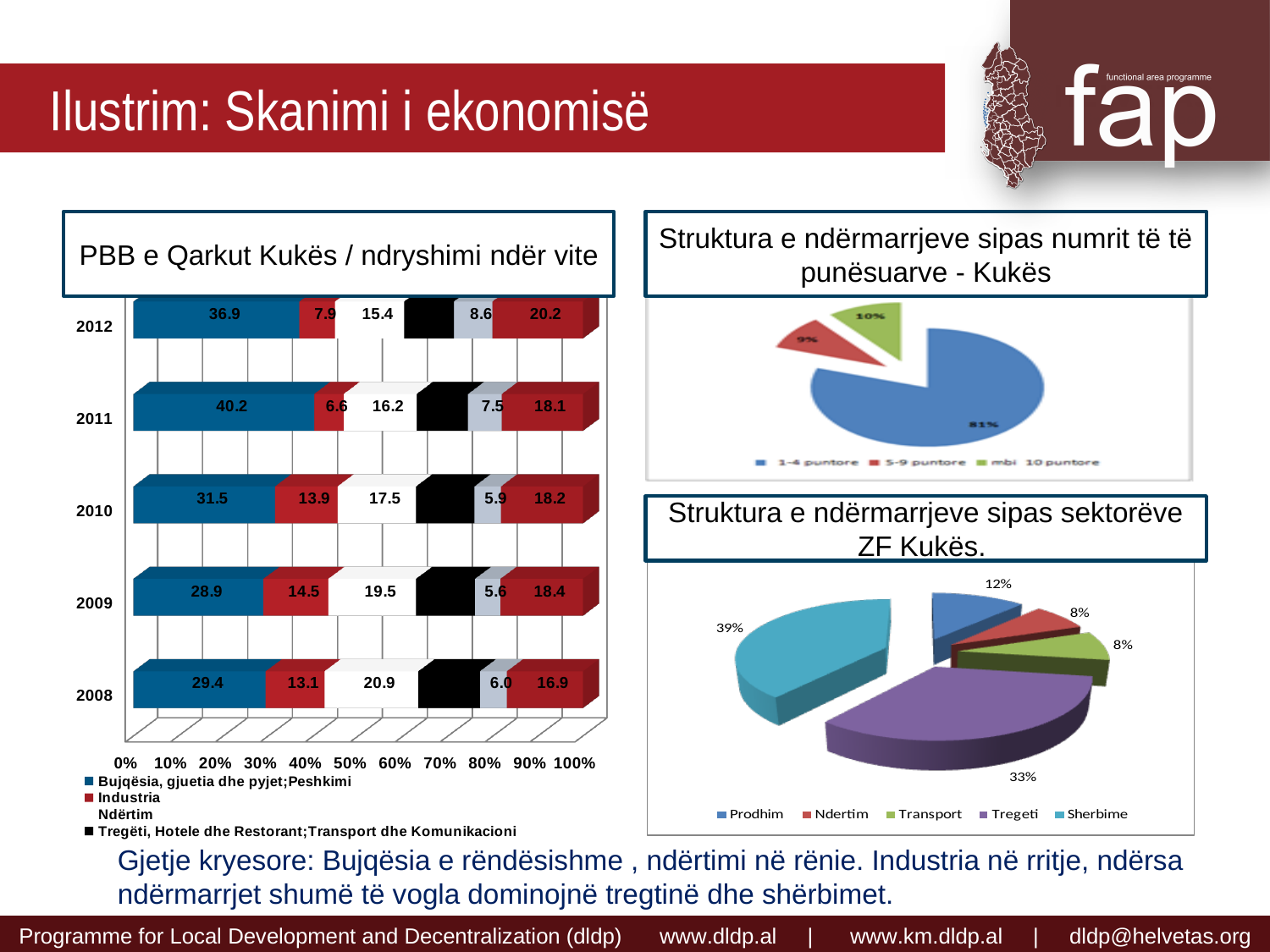
How many years are shown in the chart 'PBB e Qarkut Kukës / ndryshimi ndër vite'? 5 In the chart 'PBB e Qarkut Kukës / ndryshimi ndër vite', what is the value for Industria in 2010? 13.9 In the pie chart 'Struktura e ndërmarrjeve sipas sektorëve ZF Kukës', what is the share of Tregeti? 33% In the pie chart 'Struktura e ndërmarrjeve sipas sektorëve ZF Kukës', which sector has the largest share? Sherbime In the chart 'PBB e Qarkut Kukës / ndryshimi ndër vite', which year has the highest value for Bujqësia, gjuetia dhe pyjet;Peshkimi? 2011 In the pie chart 'Struktura e ndërmarrjeve sipas numrit të të punësuarve - Kukës', what share do enterprises with 1-4 puntore have? 81% In the chart 'PBB e Qarkut Kukës / ndryshimi ndër vite', does the Ndërtim value rise or fall from 2008 to 2012? fall In the chart 'PBB e Qarkut Kukës / ndryshimi ndër vite', is the Industria value larger in 2009 or in 2012? 2009 In the chart 'PBB e Qarkut Kukës / ndryshimi ndër vite', what is the value for Ndërtim in 2008? 20.9 What kind of chart is 'PBB e Qarkut Kukës / ndryshimi ndër vite'? bar chart In the chart 'PBB e Qarkut Kukës / ndryshimi ndër vite', what is the value for Bujqësia, gjuetia dhe pyjet;Peshkimi in 2011? 40.2 In the chart 'PBB e Qarkut Kukës / ndryshimi ndër vite', what is the difference between the Bujqësia, gjuetia dhe pyjet;Peshkimi values for 2011 and 2012? 3.3